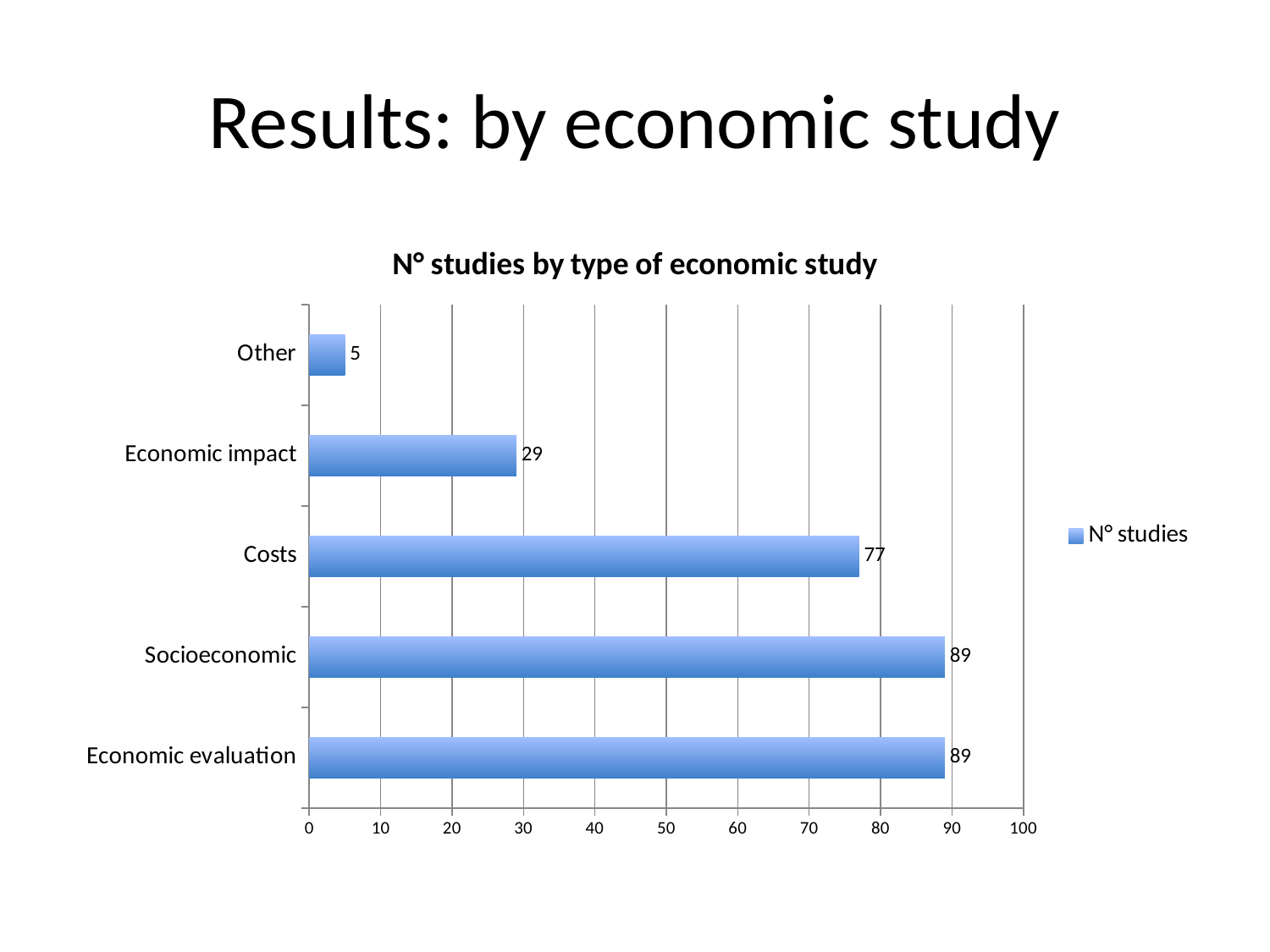
Which is larger, the value for Costs or the value for Economic impact? Costs Is the value for Costs greater or less than 70? greater What is the difference between the values for Socioeconomic and Costs? 12 What is the title of the chart? N° studies by type of economic study What is the value for Socioeconomic? 89 How many categories are shown in the chart? 5 Which category has the lowest value? Other What is the difference between the values for Costs and Economic impact? 48 What is the value for Other? 5 What kind of chart is shown on the slide? bar chart What is the value for Costs? 77 What is the value for Economic impact? 29